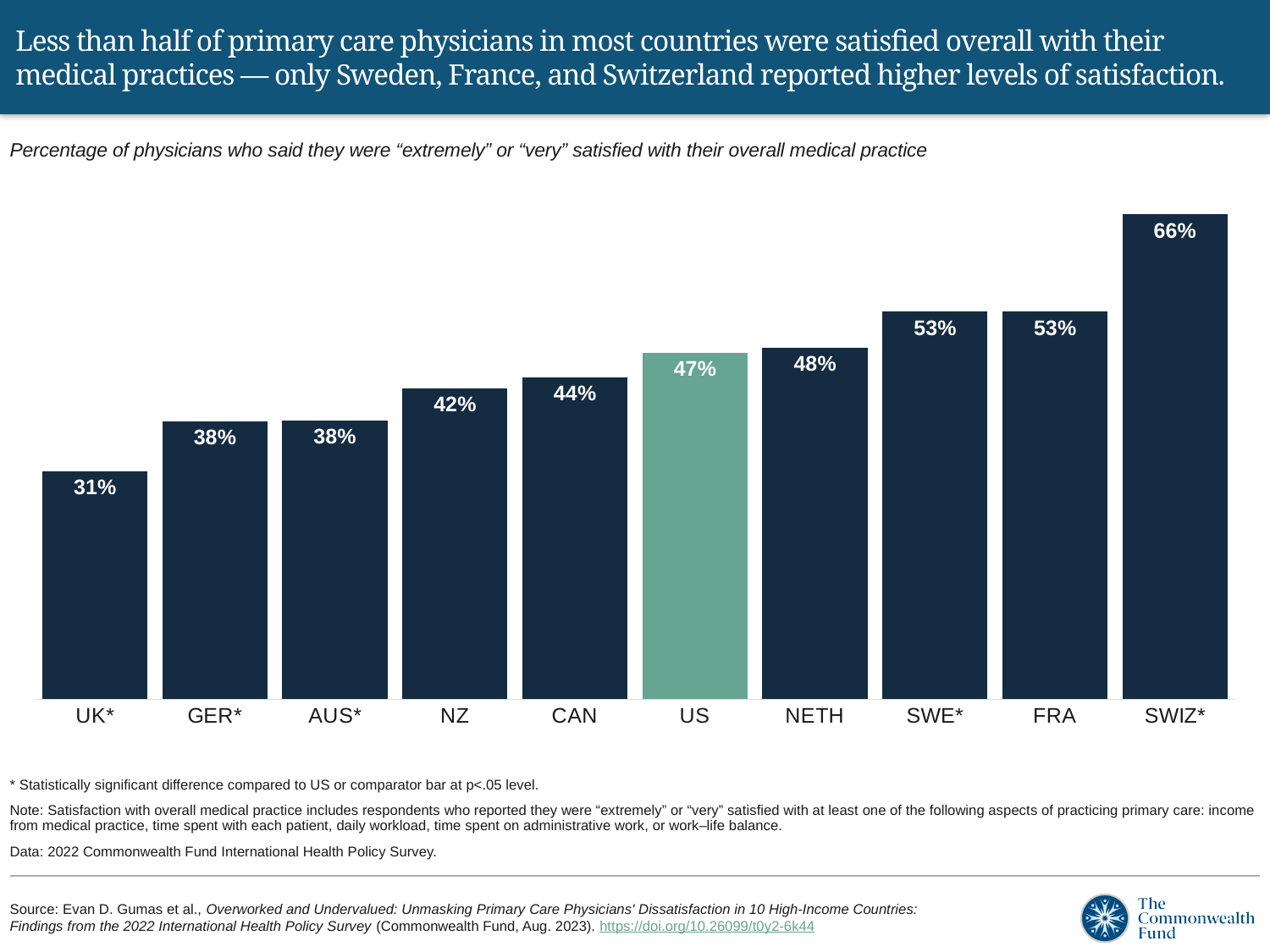
How many countries are shown in the chart? 10 What is the value shown for NETH? 48% Do the values rise or fall moving from left to right across the chart? Rise What type of chart is shown on the slide? Bar chart Which country's bar is shown in a different colour (green) from the others? US What percentage of physicians in the US said they were extremely or very satisfied with their overall medical practice? 47% Which has a higher value, SWE* or NETH? SWE* What is the difference between the values for US and CAN? 3 percentage points Which country has the lowest percentage of satisfied physicians? UK* What is the value shown for NZ? 42% What is the difference between the values for SWIZ* and UK*? 35 percentage points Which country has the highest percentage of satisfied physicians? SWIZ*